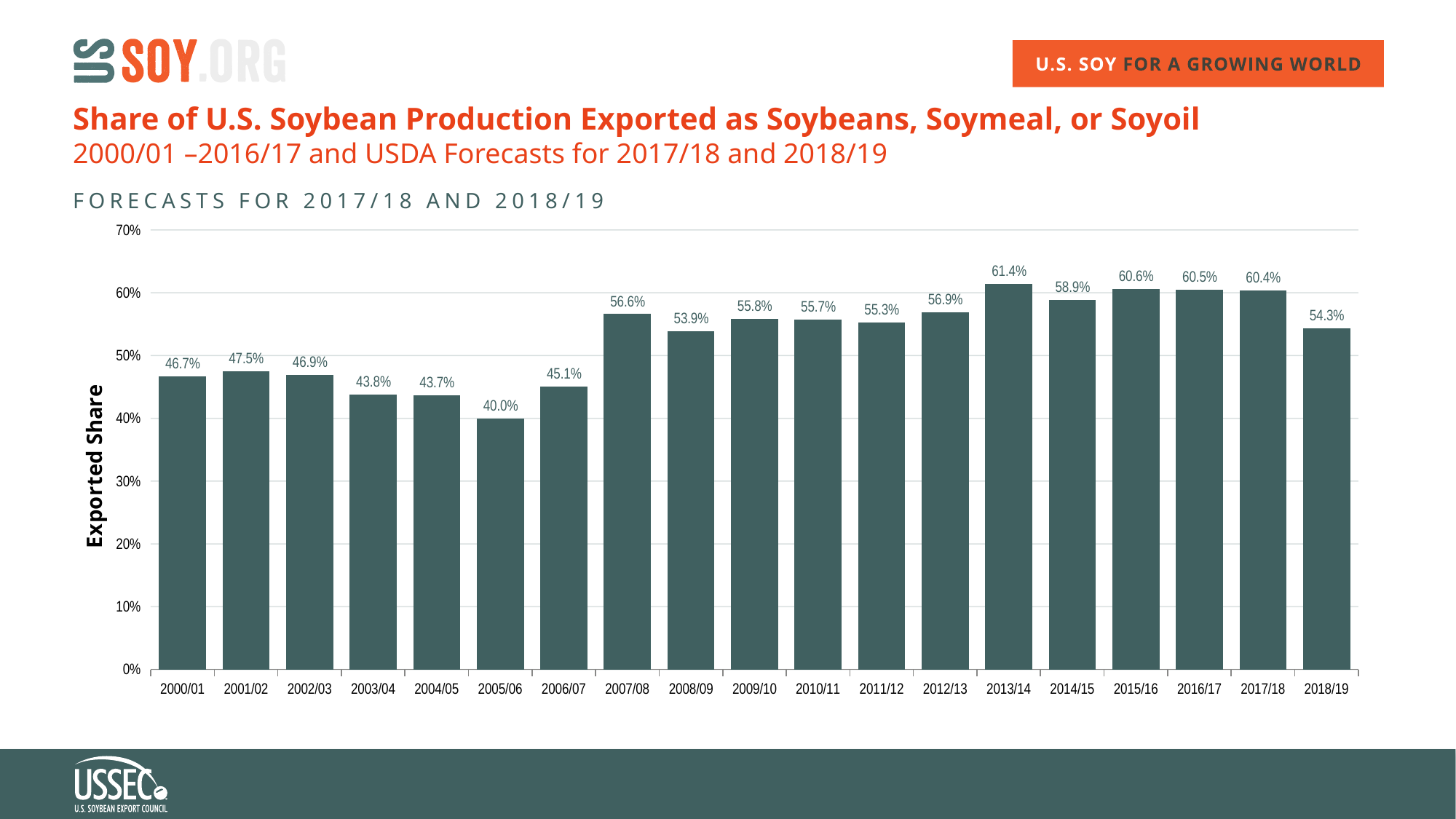
Is the exported share for 2006/07 greater or less than 50%? less Which year has a larger exported share, 2007/08 or 2008/09? 2007/08 How many years are shown on the x axis? 19 What is the difference in exported share between 2013/14 and 2005/06? 21.4 percentage points What is the exported share forecast for 2018/19? 54.3% Which year has the highest exported share? 2013/14 What is the exported share for 2013/14? 61.4% What is the exported share for 2005/06? 40.0% What is the label on the y axis of the chart? Exported Share What kind of chart is shown on the slide? Bar chart What is the difference in exported share between 2017/18 and 2018/19? 6.1 percentage points Which year has the lowest exported share? 2005/06